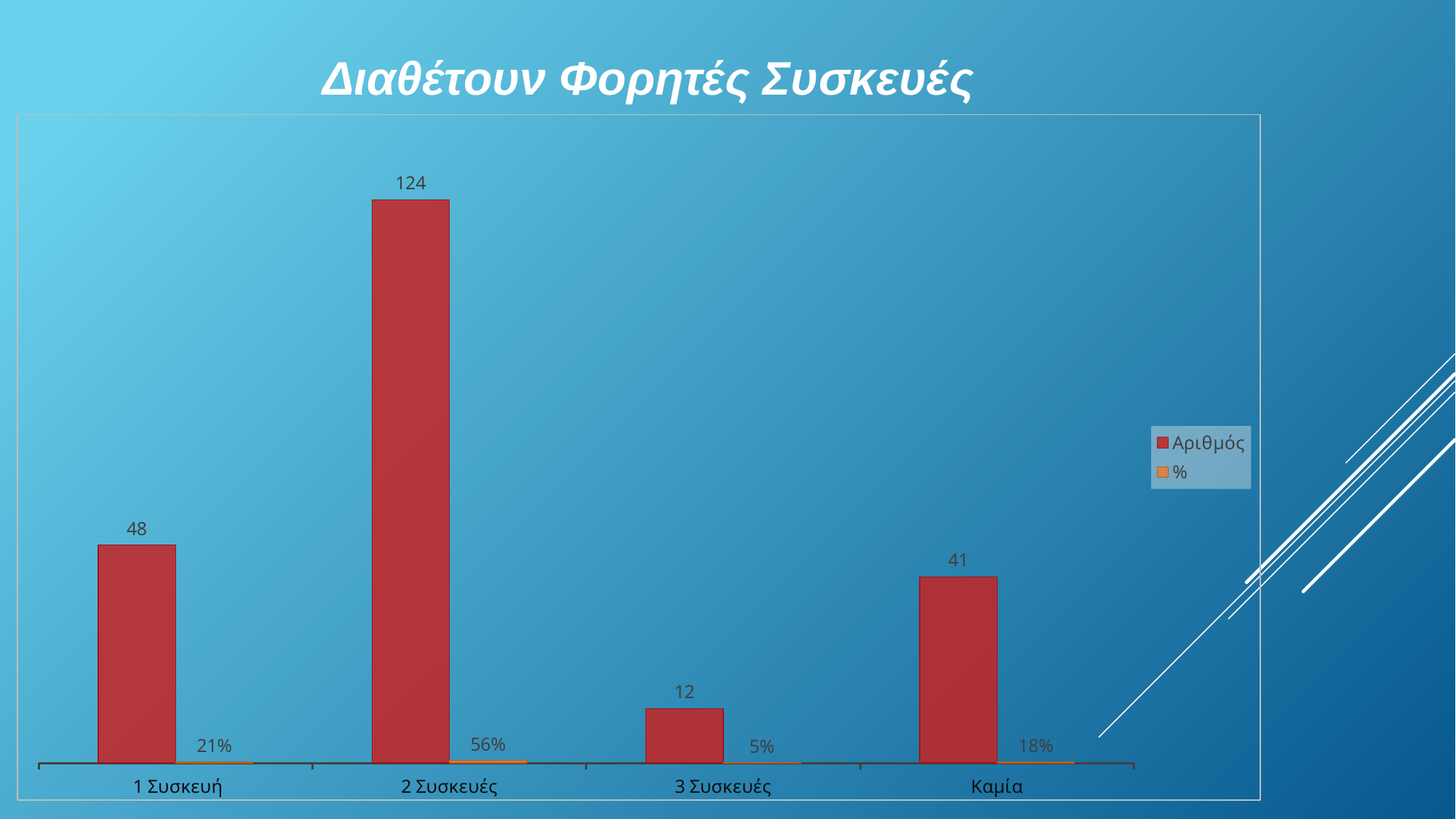
What is the Αριθμός value for 2 Συσκευές? 124 Which category has the lowest Αριθμός value? 3 Συσκευές What is the title of the chart? Διαθέτουν Φορητές Συσκευές How many series does the legend list? 2 Which has a larger Αριθμός value, 1 Συσκευή or Καμία? 1 Συσκευή What kind of chart is shown on the slide? Bar chart What is the % value for 3 Συσκευές? 5% What is the % value for 1 Συσκευή? 21% How many categories are shown on the x axis? 4 Which category has the highest Αριθμός value? 2 Συσκευές What is the difference between the Αριθμός values for 2 Συσκευές and 1 Συσκευή? 76 What is the Αριθμός value for Καμία? 41